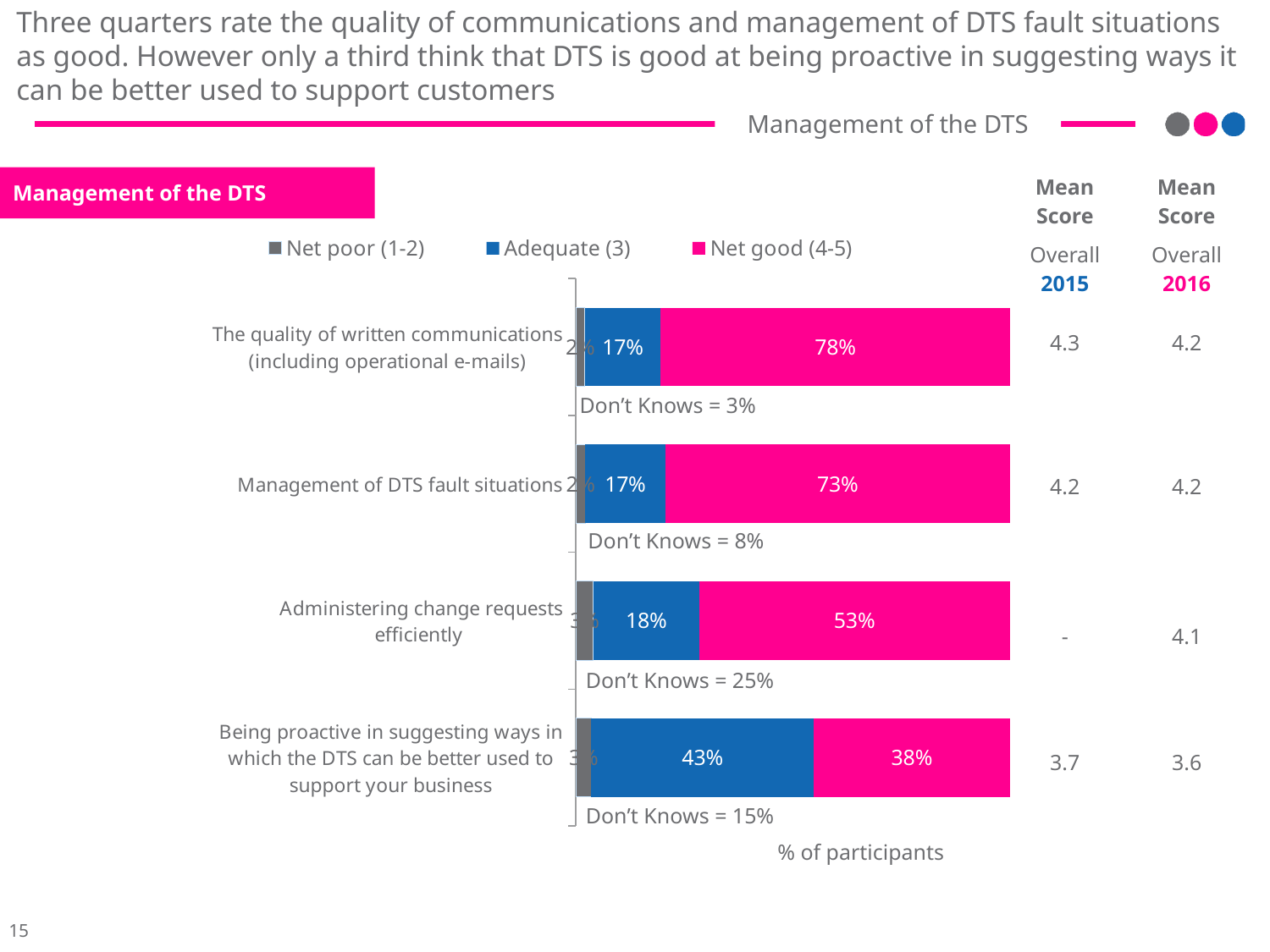
What is the title shown in the pink box above the chart? Management of the DTS How many series does the chart legend list? 3 What is the Net good (4-5) value for 'The quality of written communications (including operational e-mails)'? 78% Which category has the lowest Net good (4-5) value? Being proactive in suggesting ways in which the DTS can be better used to support your business What is the Adequate (3) value for 'Being proactive in suggesting ways in which the DTS can be better used to support your business'? 43% Which is larger for 'Being proactive in suggesting ways in which the DTS can be better used to support your business': the Adequate (3) value or the Net good (4-5) value? Adequate (3) What is the Net good (4-5) value for 'Management of DTS fault situations'? 73% What kind of chart is shown on the slide? Stacked bar chart What is the difference between the Net good (4-5) values for 'The quality of written communications' and 'Management of DTS fault situations'? 5% How many categories are plotted in the chart? 4 What is the Net good (4-5) value for 'Administering change requests efficiently'? 53% Which category has the highest Net good (4-5) value? The quality of written communications (including operational e-mails)